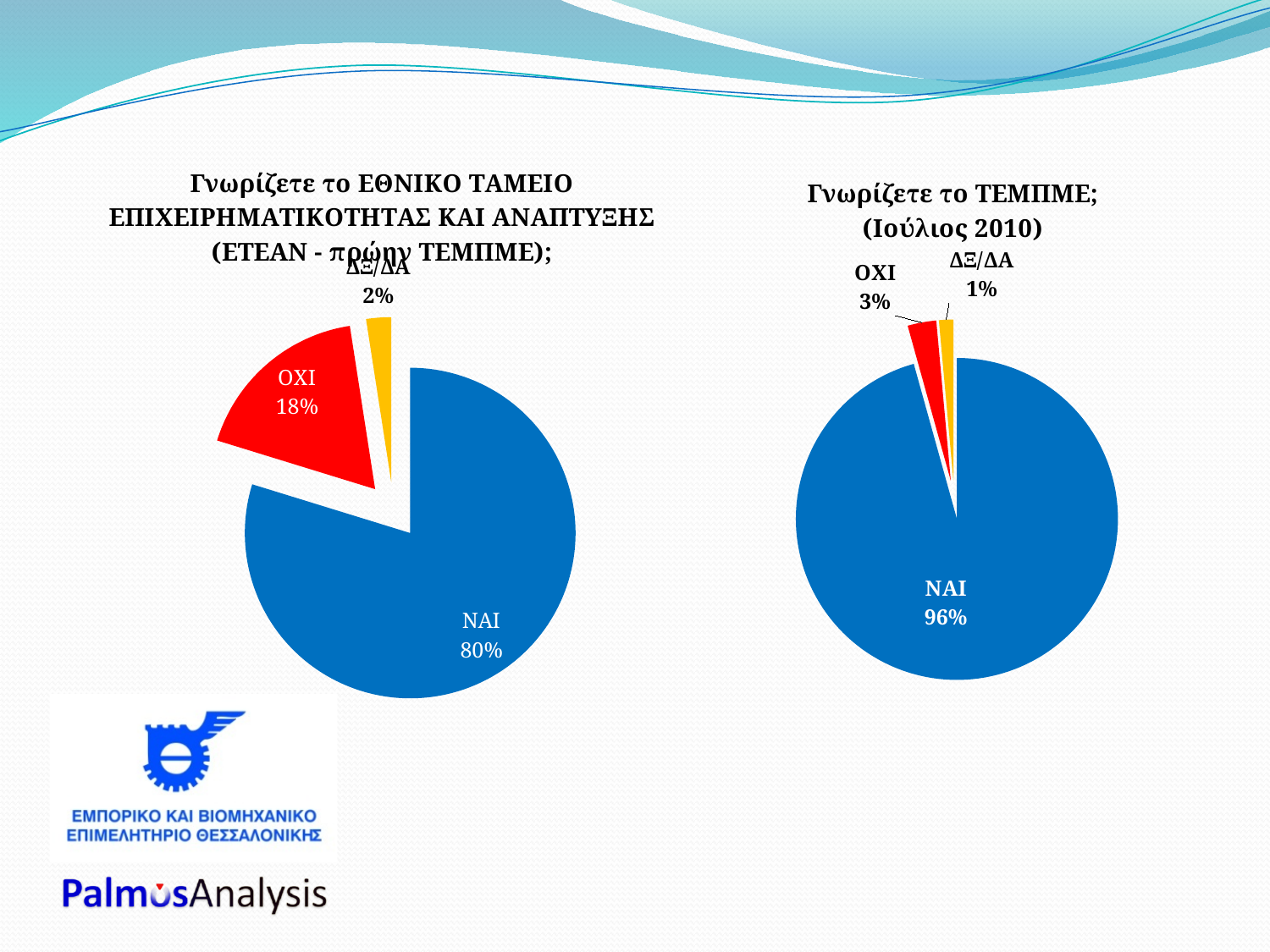
How many slices does the left pie chart (about ΕΤΕΑΝ) have? 3 In the left pie chart (about ΕΤΕΑΝ), which answer has the largest share? ΝΑΙ In the left pie chart (about ΕΤΕΑΝ), what share of respondents answered ΝΑΙ? 80% In the right pie chart (Γνωρίζετε το ΤΕΜΠΜΕ; Ιούλιος 2010), what share of respondents answered ΝΑΙ? 96% What is the difference between the ΟΧΙ share in the left pie chart and the ΟΧΙ share in the right pie chart? 15 percentage points What type of chart is used on the right side of the slide (Γνωρίζετε το ΤΕΜΠΜΕ; Ιούλιος 2010)? Pie chart Which chart shows a larger ΝΑΙ share, the left pie chart (about ΕΤΕΑΝ) or the right pie chart (about ΤΕΜΠΜΕ, Ιούλιος 2010)? The right pie chart In the left pie chart (about ΕΤΕΑΝ), what share is labelled ΔΞ/ΔΑ? 2% In the right pie chart (Γνωρίζετε το ΤΕΜΠΜΕ; Ιούλιος 2010), what share of respondents answered ΟΧΙ? 3% In the right pie chart (Γνωρίζετε το ΤΕΜΠΜΕ; Ιούλιος 2010), which answer has the smallest share? ΔΞ/ΔΑ In the left pie chart (about ΕΤΕΑΝ), what share of respondents answered ΟΧΙ? 18% In the right pie chart (Γνωρίζετε το ΤΕΜΠΜΕ; Ιούλιος 2010), what share is labelled ΔΞ/ΔΑ? 1%